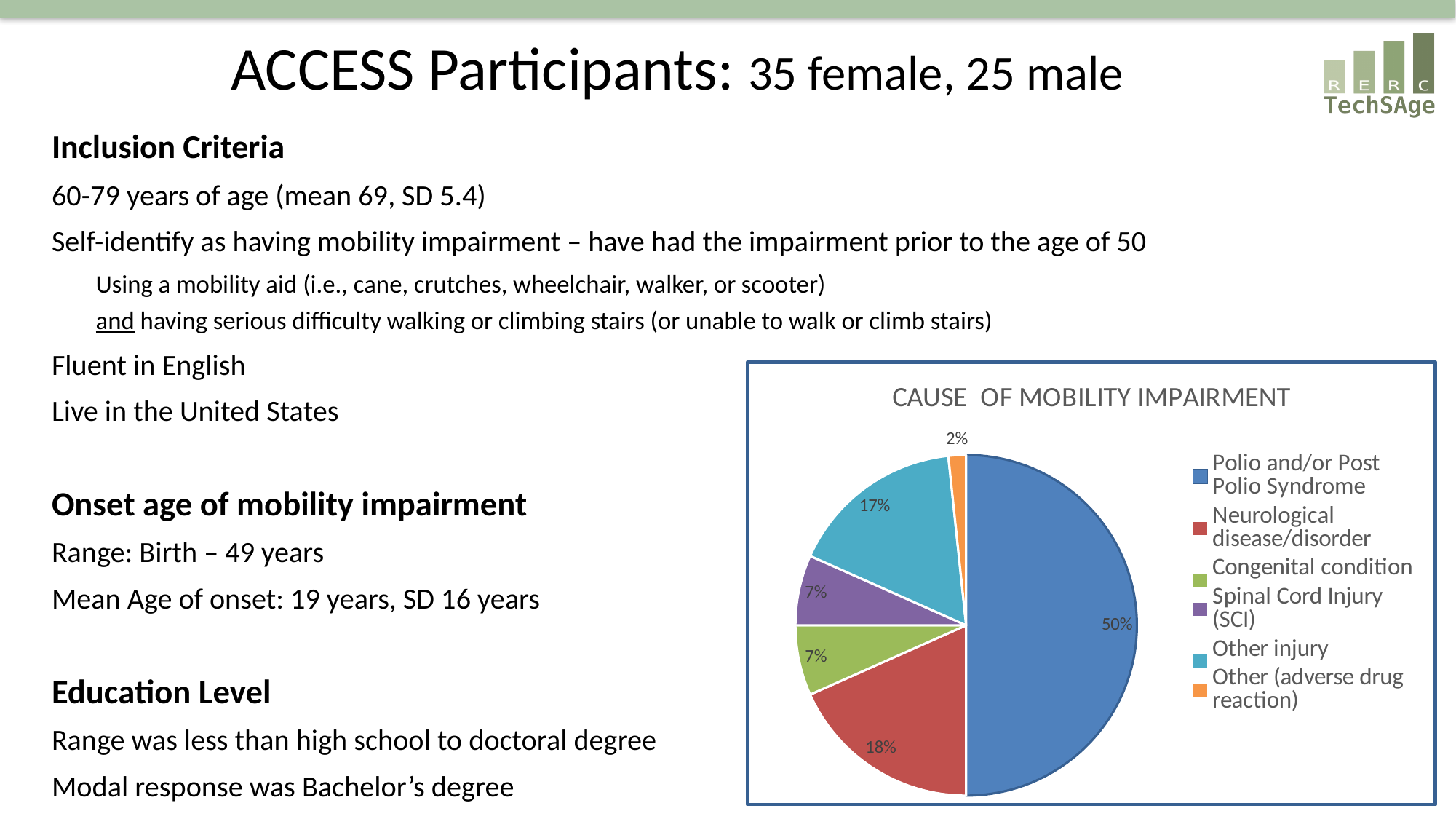
What percentage is shown for Other (adverse drug reaction)? 2% What type of chart is shown on the slide? pie chart What share of the pie is Polio and/or Post Polio Syndrome? 50% What percentage is shown for Other injury? 17% Which cause of mobility impairment has the smallest share? Other (adverse drug reaction) How many categories does the legend list? 6 Which cause of mobility impairment has the largest share? Polio and/or Post Polio Syndrome What percentage is shown for Spinal Cord Injury (SCI)? 7% What percentage of participants have a Neurological disease/disorder as the cause of mobility impairment? 18% What is the title of the chart? CAUSE OF MOBILITY IMPAIRMENT Which is larger, the share for Other injury or the share for Congenital condition? Other injury What is the difference in percentage points between Polio and/or Post Polio Syndrome and Neurological disease/disorder? 32